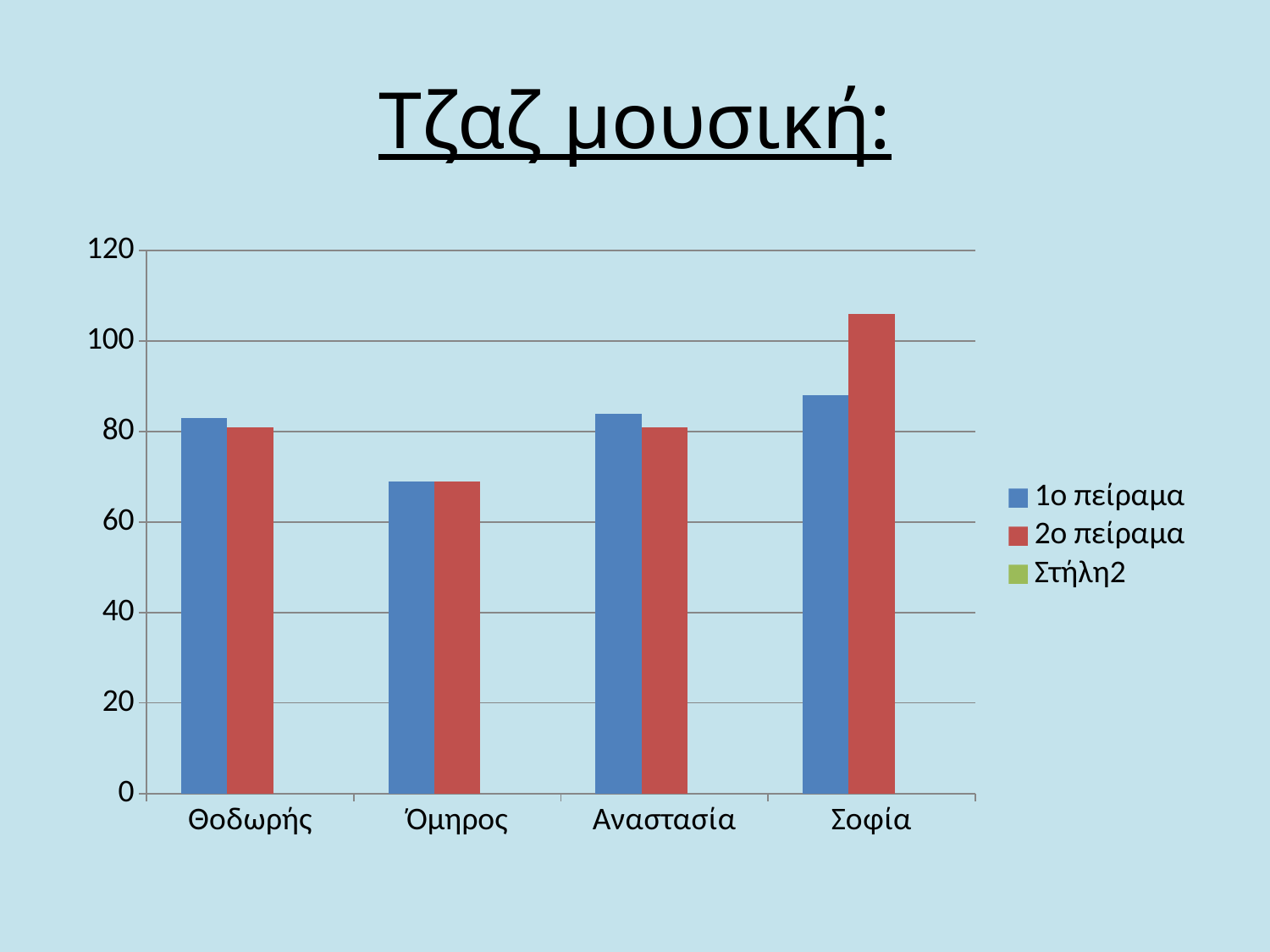
Which category has the highest value for 2ο πείραμα? Σοφία How many categories (people) are shown on the x axis? 4 How many series does the legend list? 3 What is the title of the slide? Τζαζ μουσική: What kind of chart is shown on the slide? bar chart Is the value for Σοφία in 2ο πείραμα greater or less than 100? greater For Σοφία, which is larger: the value for 1ο πείραμα or 2ο πείραμα? 2ο πείραμα Is the value for Όμηρος in 1ο πείραμα greater or less than 80? less Is the value for Θοδωρής in 1ο πείραμα greater or less than 80? greater Which category has the lowest value for 1ο πείραμα? Όμηρος Which category has the lowest value for 2ο πείραμα? Όμηρος Which legend entry is shown in red? 2ο πείραμα